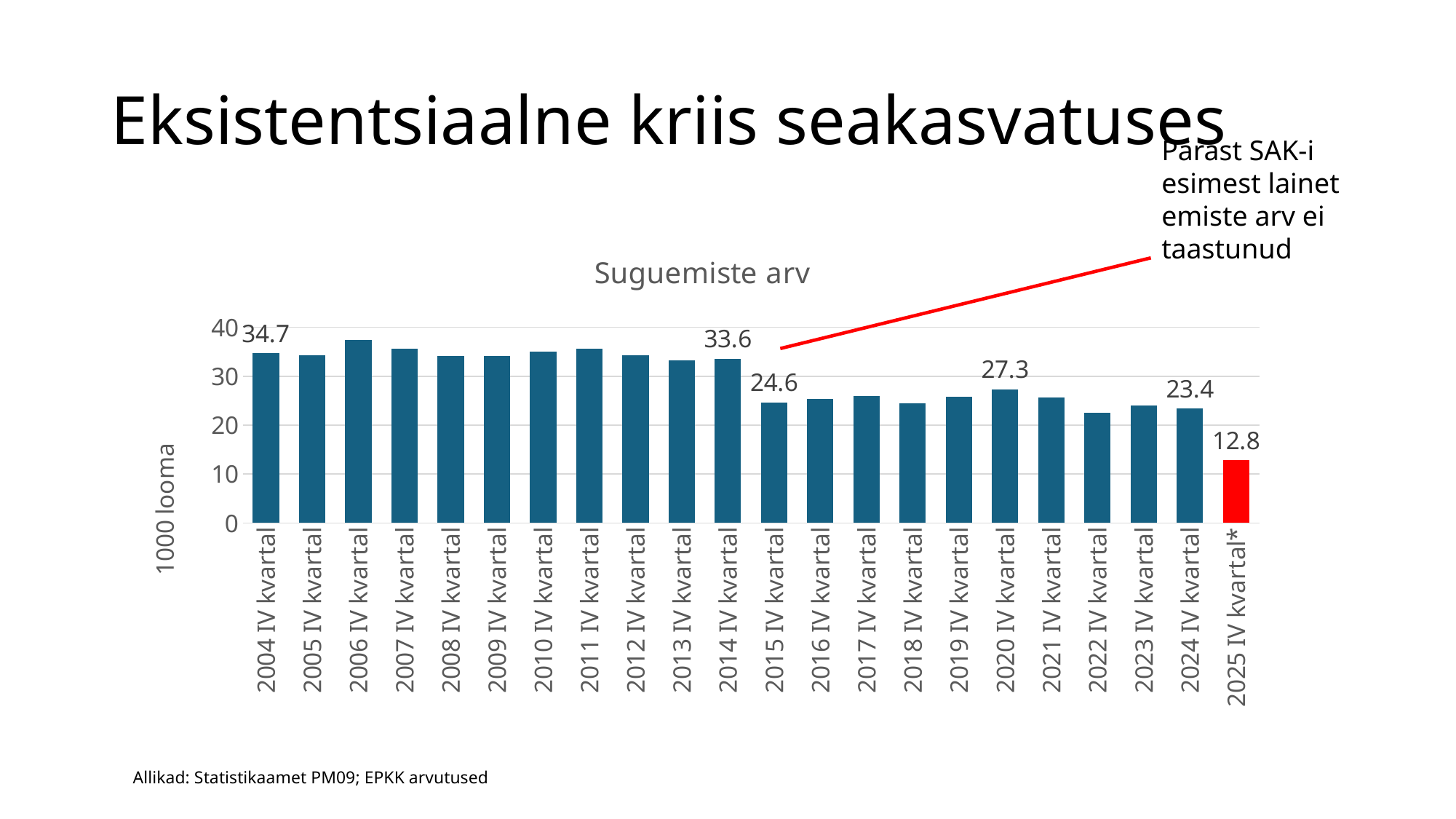
Which is larger, the value for 2015 IV kvartal or 2020 IV kvartal? 2020 IV kvartal Which category has the lowest value? 2025 IV kvartal* What is the value for 2015 IV kvartal? 24.6 How many categories are shown on the x axis? 22 What is the value for 2025 IV kvartal*? 12.8 What is the value for 2004 IV kvartal? 34.7 Which category has the highest value? 2006 IV kvartal What kind of chart is shown? bar chart What is the title of the chart? Suguemiste arv Is the value for 2022 IV kvartal greater or less than 30? less What is the difference between the values for 2024 IV kvartal and 2025 IV kvartal*? 10.6 What is the difference between the values for 2014 IV kvartal and 2015 IV kvartal? 9.0